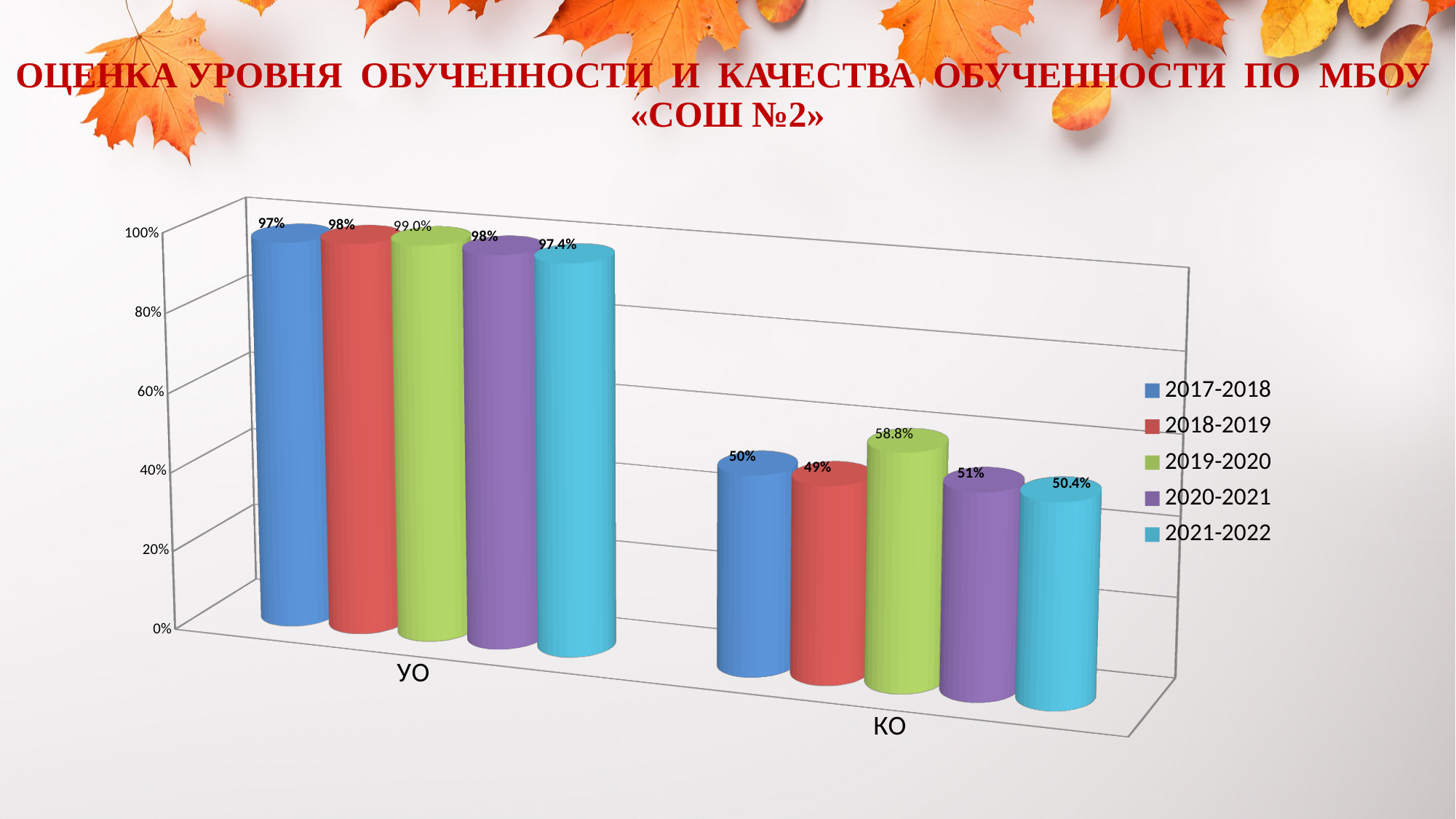
How many series does the legend list? 5 Which series has the highest value in the КО category? 2019-2020 What is the difference between the 2019-2020 and 2018-2019 values in the КО category? 9.8% What is the value for 2021-2022 in the КО category? 50.4% What is the value for 2018-2019 in the КО category? 49% Is the value for 2021-2022 in the УО category greater or less than 80%? greater What is the value for 2019-2020 in the УО category? 99.0% Which series has the lowest value in the КО category? 2018-2019 What is the value for 2017-2018 in the УО category? 97% Which is larger in the КО category: the value for 2020-2021 or the value for 2021-2022? 2020-2021 How many categories are shown on the x axis? 2 What kind of chart is shown on the slide? bar chart